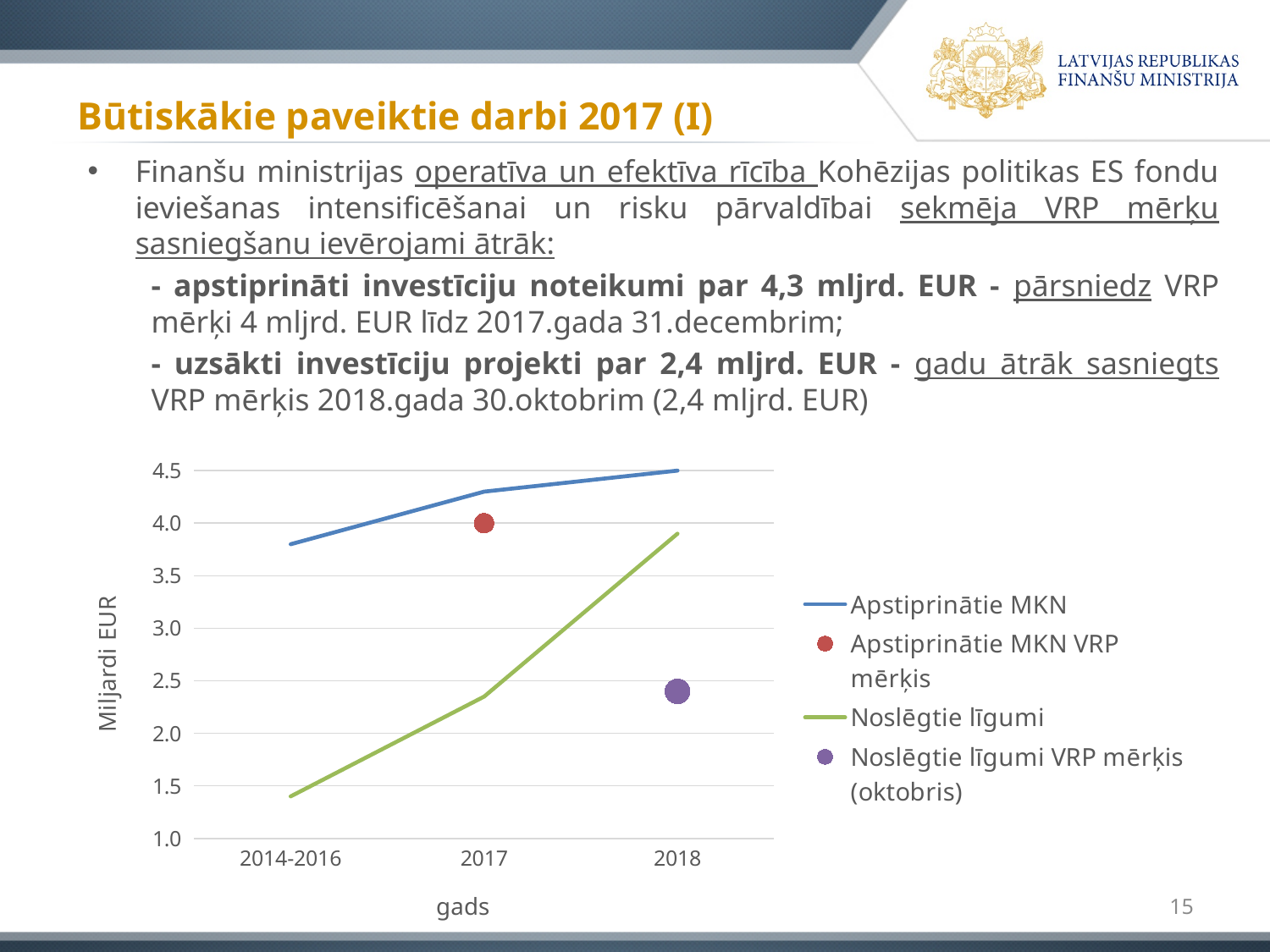
How many categories are shown on the x axis of the chart? 3 In which year does the Apstiprinātie MKN line reach its highest value? 2018 What is the label of the y axis of the chart? Miljardi EUR In 2017, which is larger: Apstiprinātie MKN or Noslēgtie līgumi? Apstiprinātie MKN Does the Apstiprinātie MKN line rise or fall from 2014-2016 to 2018? rise Does the Noslēgtie līgumi line rise or fall from 2014-2016 to 2018? rise Is the value for Apstiprinātie MKN in 2018 greater or less than 4.0? greater How many entries does the chart legend list? 4 Is the value for Apstiprinātie MKN in 2014-2016 greater or less than 3.5? greater Is the value for Noslēgtie līgumi in 2018 greater or less than 3.5? greater What is the label of the x axis of the chart? gads What kind of chart is shown on the slide? line chart